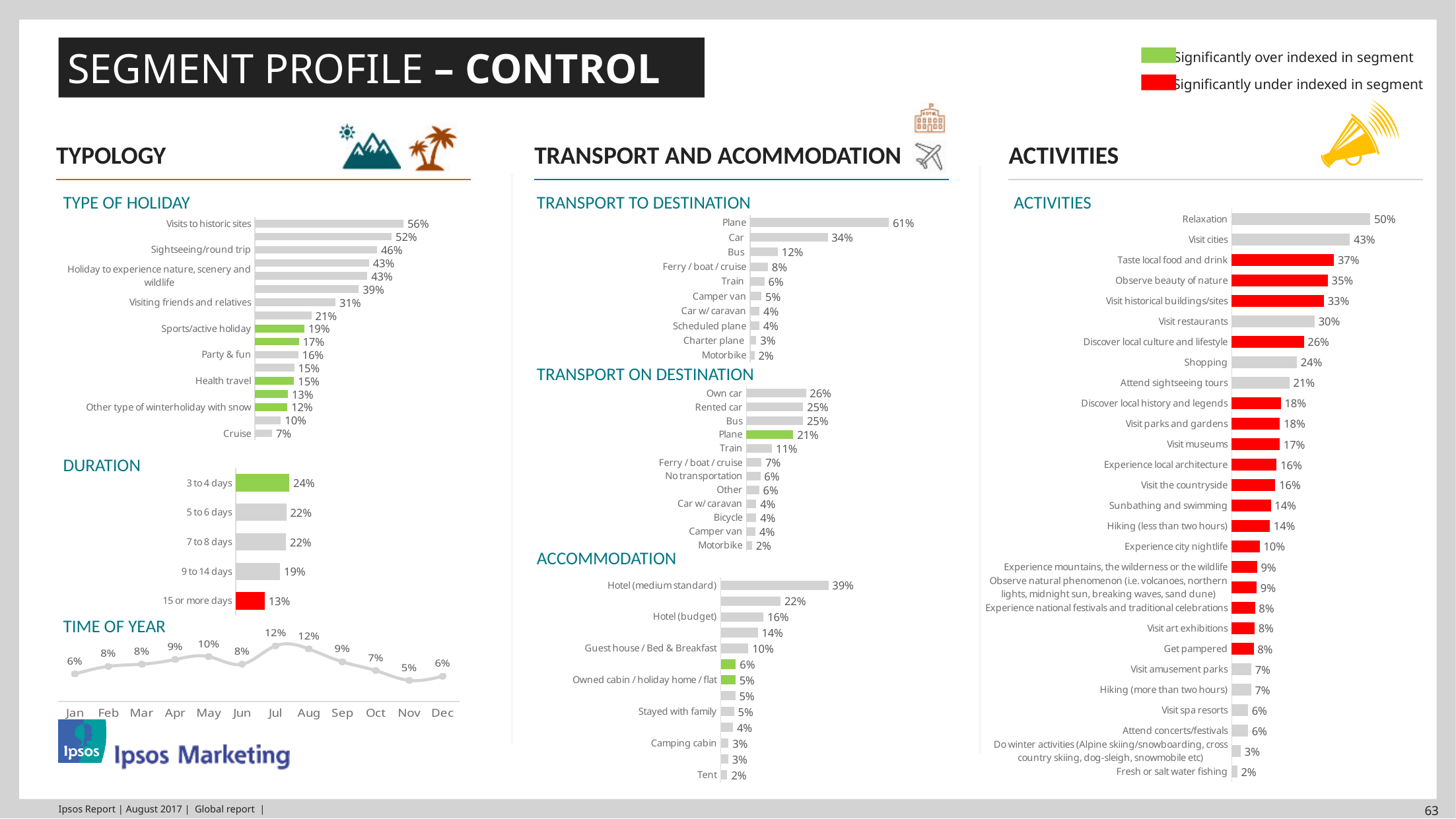
In the Type of Holiday chart, what is the value for Cruise? 7% In the Accommodation chart, what percentage is shown for Hotel (medium standard)? 39% In the Activities chart, what is the difference between the values for Visit cities and Shopping? 19% In the Activities chart, which activity has the highest value? Relaxation In the Transport on Destination chart, which is larger, the value for Own car or the value for Plane? Own car In the Time of Year chart, how many months are plotted? 12 In the Time of Year chart, which month has the lowest value? Nov In the Duration chart, what is the value for 15 or more days? 13% What kind of chart is the Time of Year chart? Line chart In the Transport to Destination chart, what percentage is shown for Plane? 61% In the Duration chart, what is the difference between the values for 3 to 4 days and 9 to 14 days? 5% According to the legend at the top right, what does a green bar indicate? Significantly over indexed in segment